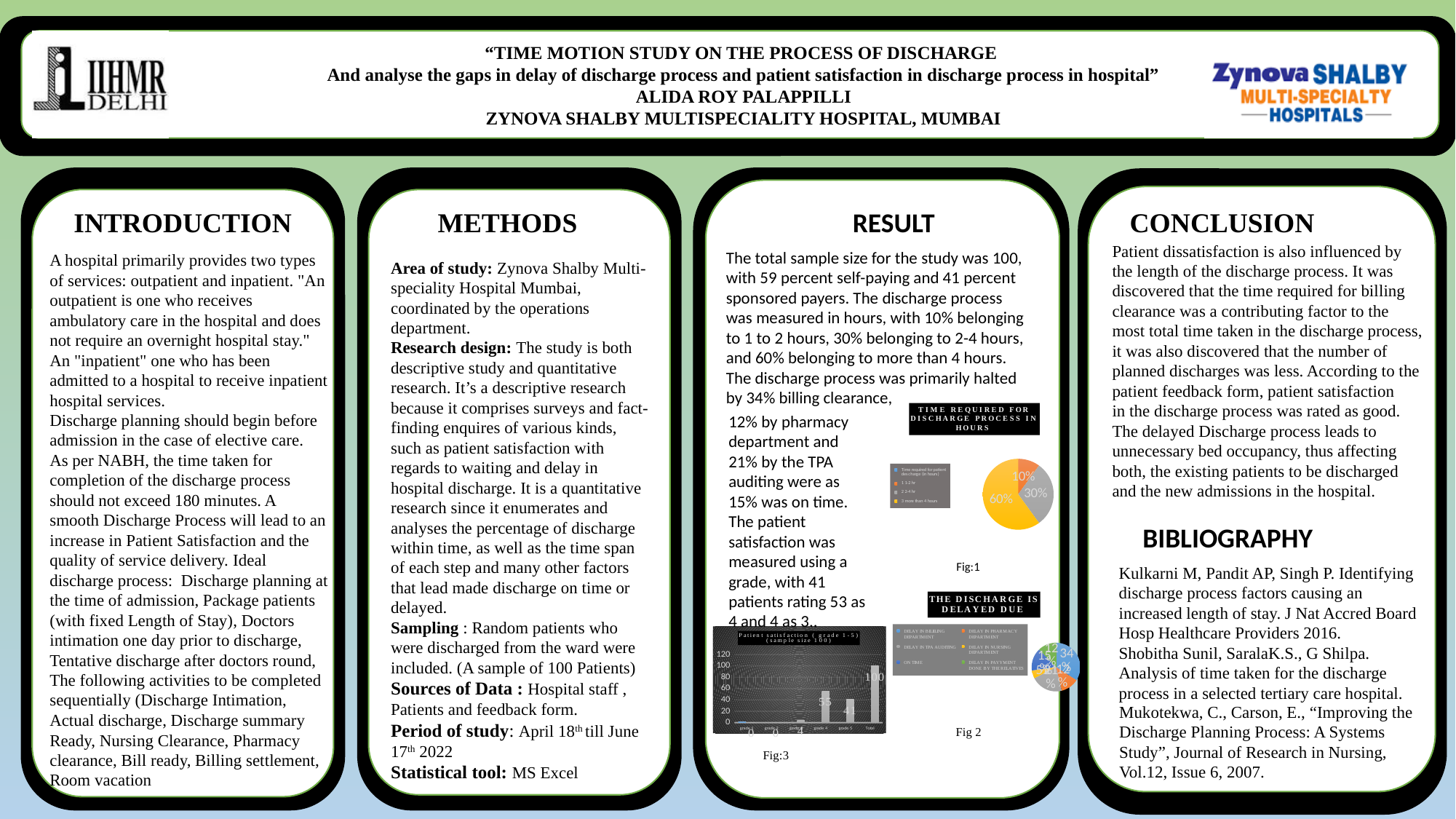
In the bar chart "Patient satisfaction (grade 1-5)" (Fig:3), which is larger, grade 4 or grade 5? grade 4 In the pie chart "TIME REQUIRED FOR DISCHARGE PROCESS IN HOURS" (Fig:1), how many slices are there? 3 What type of chart is Fig 2, titled "THE DISCHARGE IS DELAYED DUE"? pie chart In the pie chart "TIME REQUIRED FOR DISCHARGE PROCESS IN HOURS" (Fig:1), what is the smallest slice's share? 10% What type of chart is Fig:1, titled "TIME REQUIRED FOR DISCHARGE PROCESS IN HOURS"? pie chart In the pie chart "TIME REQUIRED FOR DISCHARGE PROCESS IN HOURS" (Fig:1), what is the difference between the largest and the smallest slice? 50% In the bar chart "Patient satisfaction (grade 1-5)" (Fig:3), what is the value for grade 5? 41 In the bar chart "Patient satisfaction (grade 1-5)" (Fig:3), what is the value for grade 4? 55 In the bar chart "Patient satisfaction (grade 1-5)" (Fig:3), what is the difference between grade 4 and grade 5? 14 What type of chart is Fig:3, titled "Patient satisfaction (grade 1-5) (sample size 100)"? bar chart In the pie chart "TIME REQUIRED FOR DISCHARGE PROCESS IN HOURS" (Fig:1), what is the largest slice's share? 60% In the bar chart "Patient satisfaction (grade 1-5)" (Fig:3), what is the value of the Total bar? 100